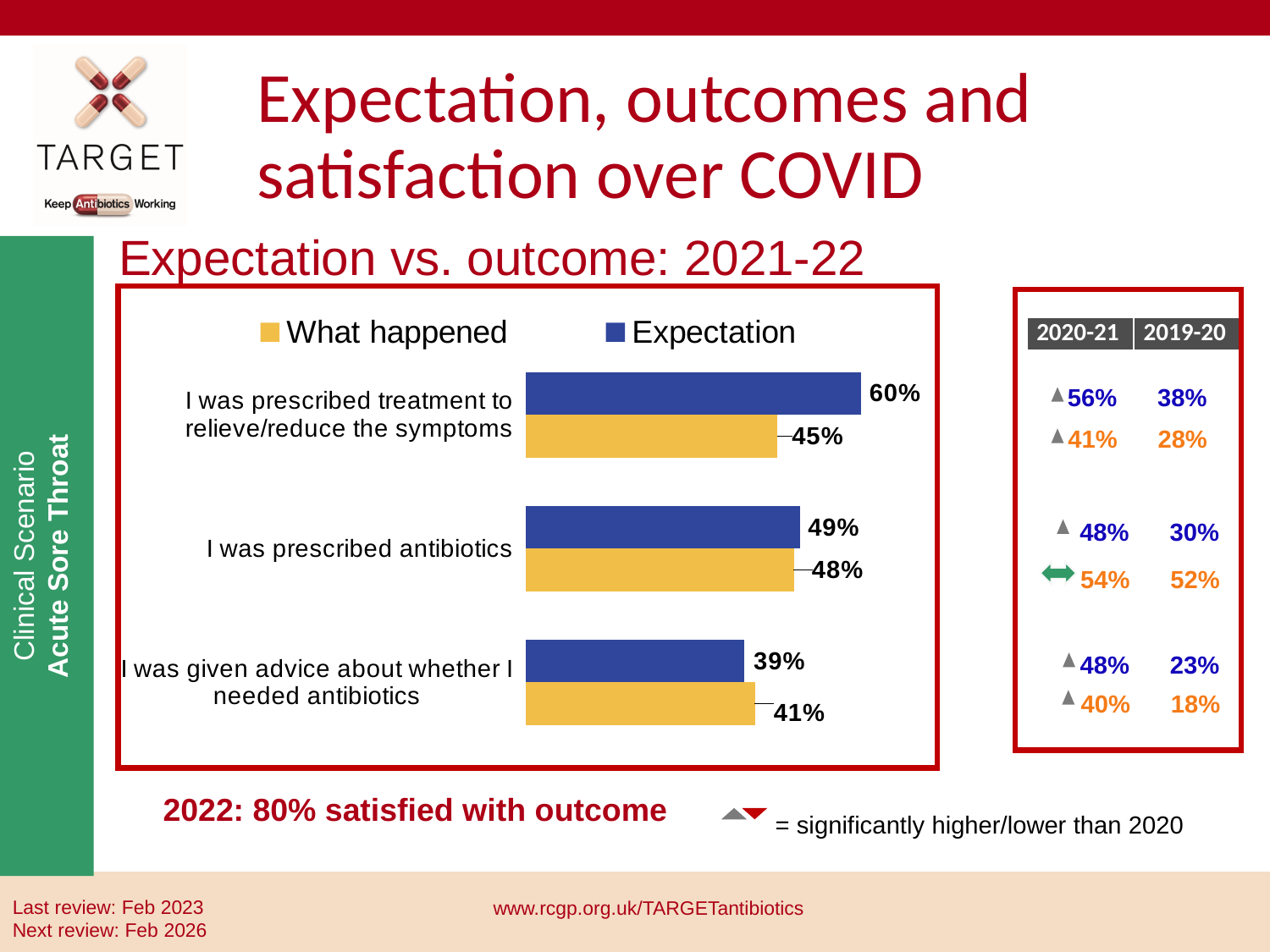
What is the Expectation value for "I was prescribed treatment to relieve/reduce the symptoms"? 60% How many categories are shown in the chart? 3 What is the Expectation value for "I was given advice about whether I needed antibiotics"? 39% Which category has the highest Expectation value? I was prescribed treatment to relieve/reduce the symptoms What type of chart is shown on the slide? Bar chart For "I was given advice about whether I needed antibiotics", which is larger: Expectation or What happened? What happened Which category has the lowest What happened value? I was given advice about whether I needed antibiotics What is the difference between the Expectation and What happened values for "I was prescribed treatment to relieve/reduce the symptoms"? 15% What is the What happened value for "I was given advice about whether I needed antibiotics"? 41% What is the What happened value for "I was prescribed antibiotics"? 48% How many series does the chart legend list? 2 What colour are the Expectation bars in the chart? Blue